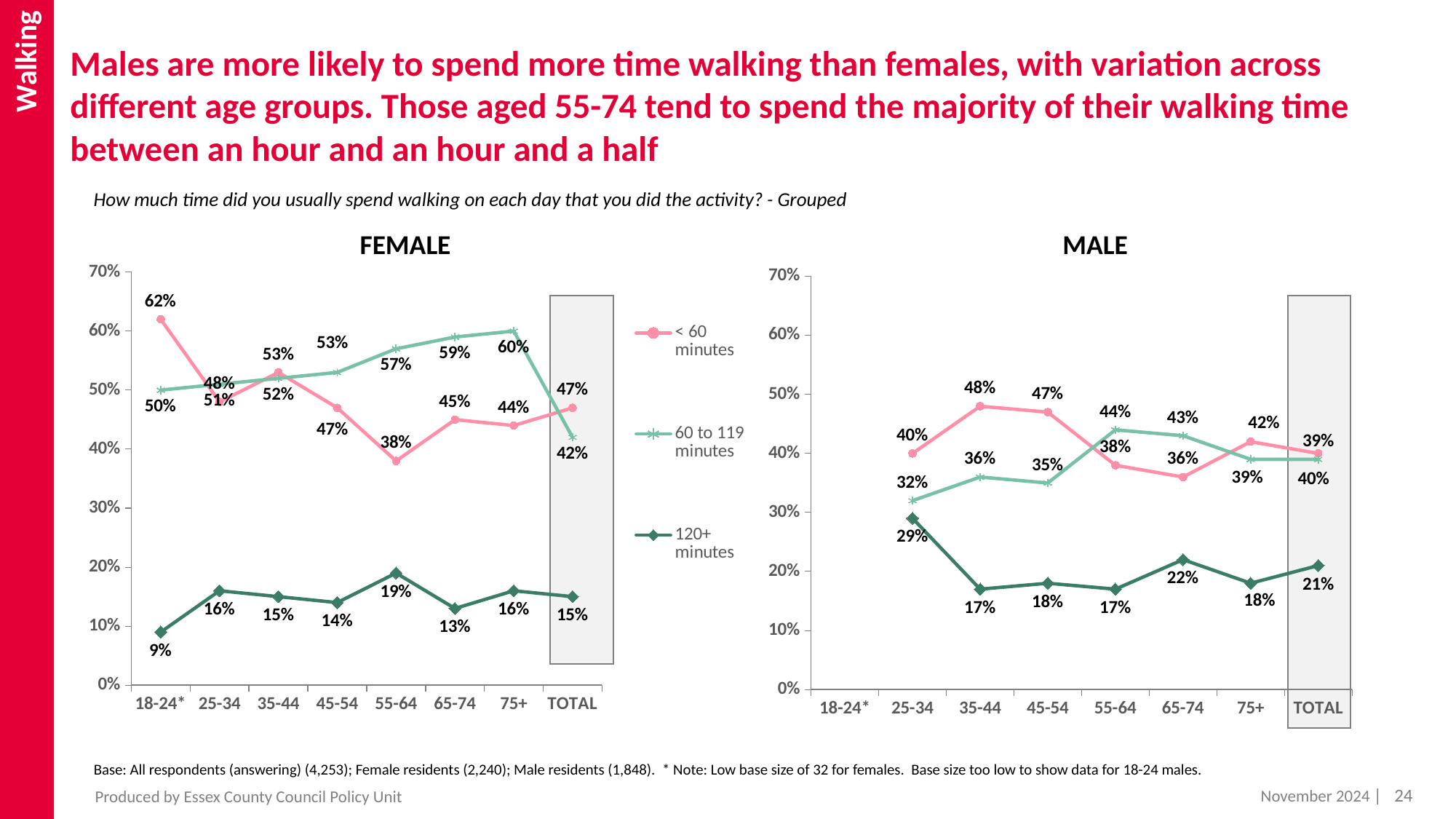
On the FEMALE chart, what is the value for 120+ minutes in the 55-64 age group? 19% On the FEMALE chart, which age group has the lowest value for 120+ minutes? 18-24* What kind of chart is the FEMALE chart? Line chart On the FEMALE chart, what is the difference between < 60 minutes and 60 to 119 minutes in the 18-24* age group? 12 percentage points On the MALE chart, what is the value for 120+ minutes in the 25-34 age group? 29% On the FEMALE chart, which age group has the highest value for 60 to 119 minutes? 75+ On the MALE chart, what is the value for 60 to 119 minutes in the 55-64 age group? 44% On the MALE chart, in the 65-74 age group, which is larger: < 60 minutes or 60 to 119 minutes? 60 to 119 minutes On the FEMALE chart, what is the value for < 60 minutes in the 18-24* age group? 62% How many series does the legend list? 3 On the MALE chart, which age group has the highest value for < 60 minutes? 35-44 On the MALE chart, what is the TOTAL value for 120+ minutes? 21%